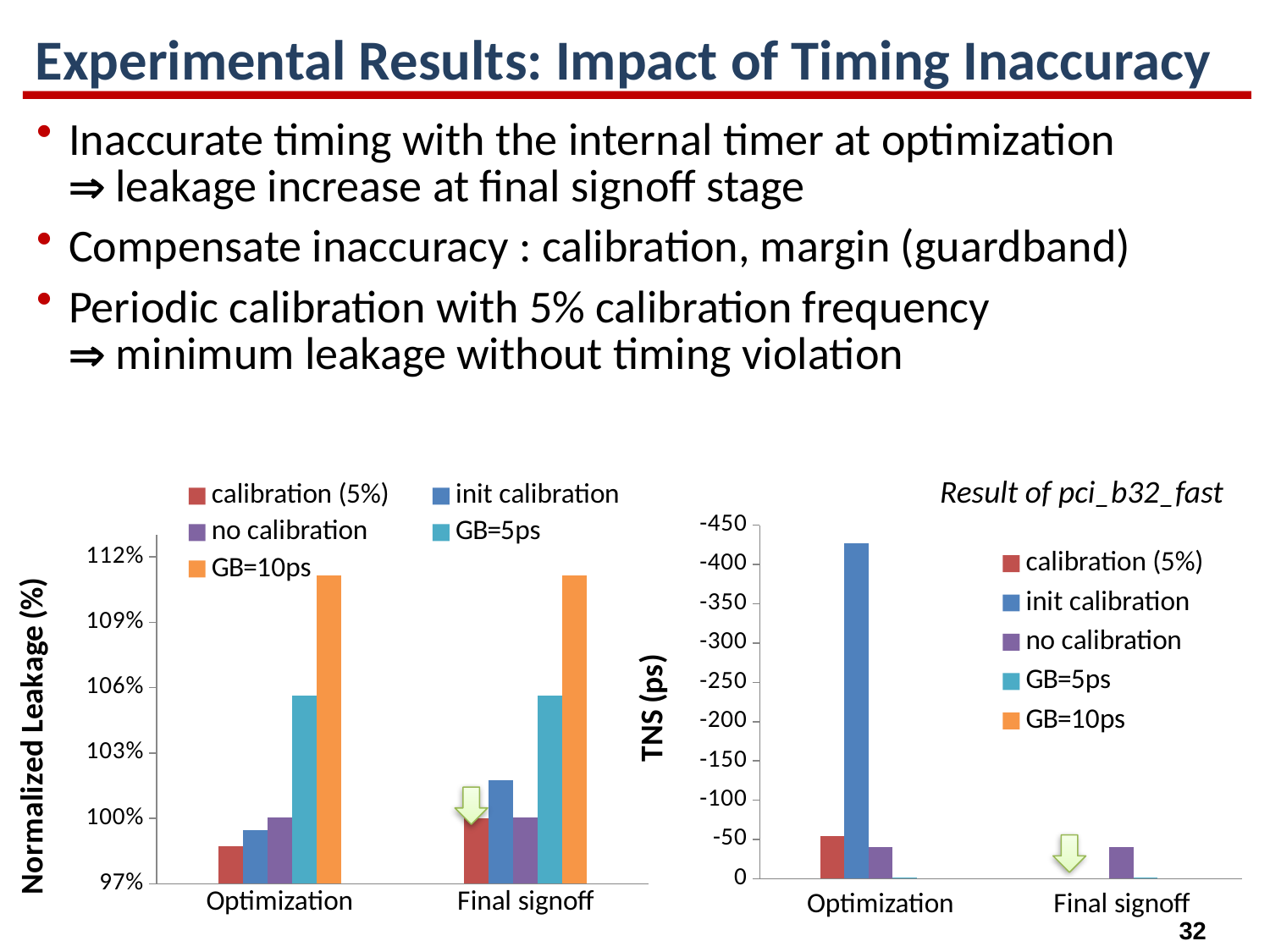
In the left chart (Normalized Leakage), how many series does the legend list? 5 In the left chart (Normalized Leakage), is the value for GB=10ps at Optimization greater or less than 109%? greater In the left chart (Normalized Leakage), which series has the highest value at Final signoff? GB=10ps In the left chart (Normalized Leakage), is the value for GB=5ps at Final signoff greater or less than 103%? greater In the left chart (Normalized Leakage), which is larger at Optimization: GB=10ps or GB=5ps? GB=10ps In the left chart (Normalized Leakage), is the value for calibration (5%) at Optimization greater or less than 100%? less What type of chart is the left chart showing Normalized Leakage (%)? bar chart In the right chart (TNS), how many categories are shown on the x axis? 2 In the right chart (TNS), which series has the largest magnitude of TNS at Optimization? init calibration In the left chart (Normalized Leakage), which series has the lowest value at Optimization? calibration (5%) What is the title shown above the right chart? Result of pci_b32_fast